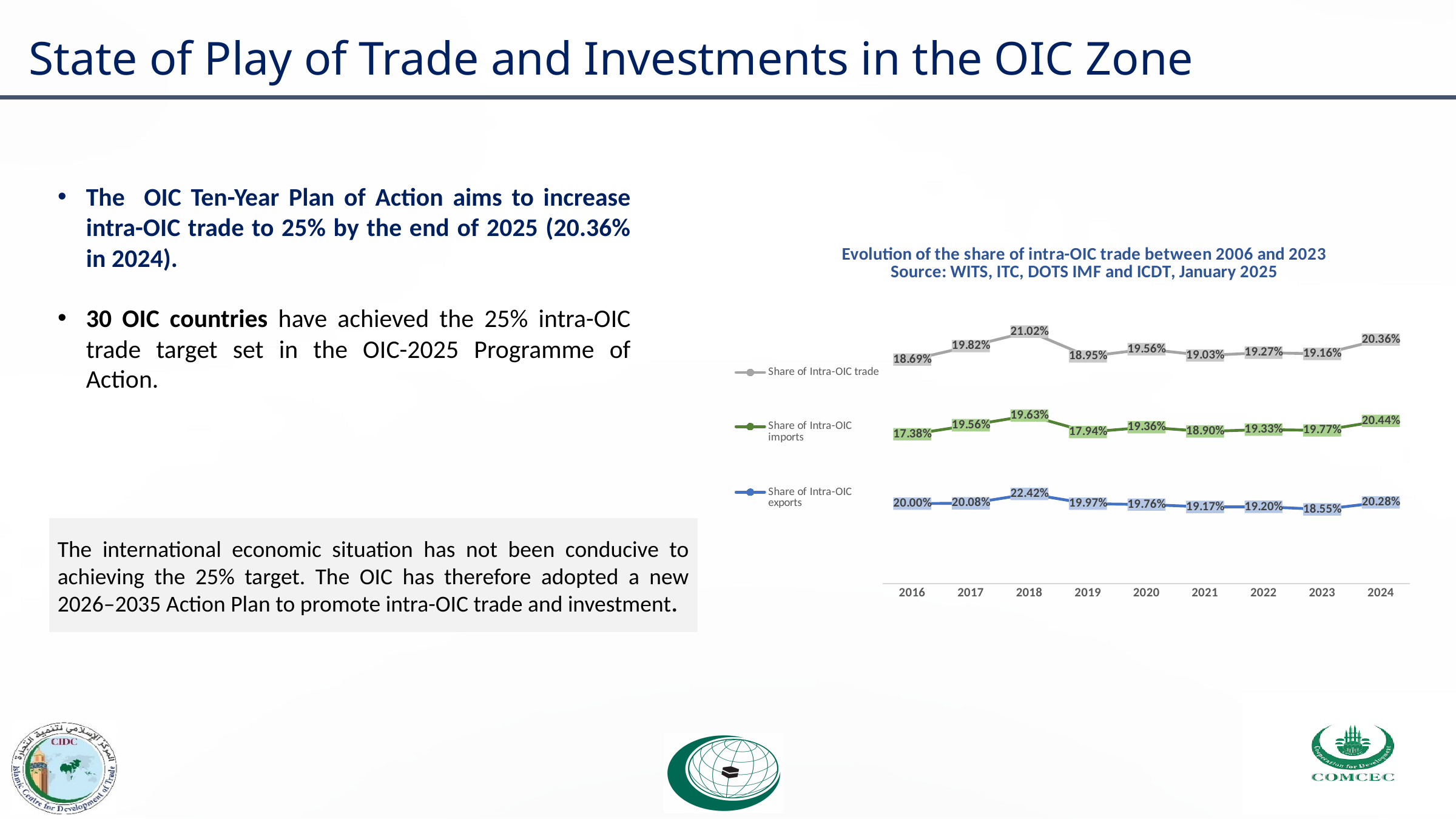
In which year is the Share of Intra-OIC exports highest? 2018 What is the Share of Intra-OIC imports in 2016? 17.38% Does the Share of Intra-OIC trade rise or fall from 2023 to 2024? Rise What is the title of the chart? Evolution of the share of intra-OIC trade between 2006 and 2023 How many series does the chart legend list? 3 What is the Share of Intra-OIC trade in 2018? 21.02% Which is larger in 2024: the Share of Intra-OIC imports or the Share of Intra-OIC exports? Share of Intra-OIC imports In which year is the Share of Intra-OIC imports lowest? 2016 How many years are shown on the x axis of the chart? 9 What is the Share of Intra-OIC exports in 2023? 18.55% What type of chart is shown on the slide? Line chart What is the difference between the Share of Intra-OIC trade in 2024 and in 2016? 1.67%